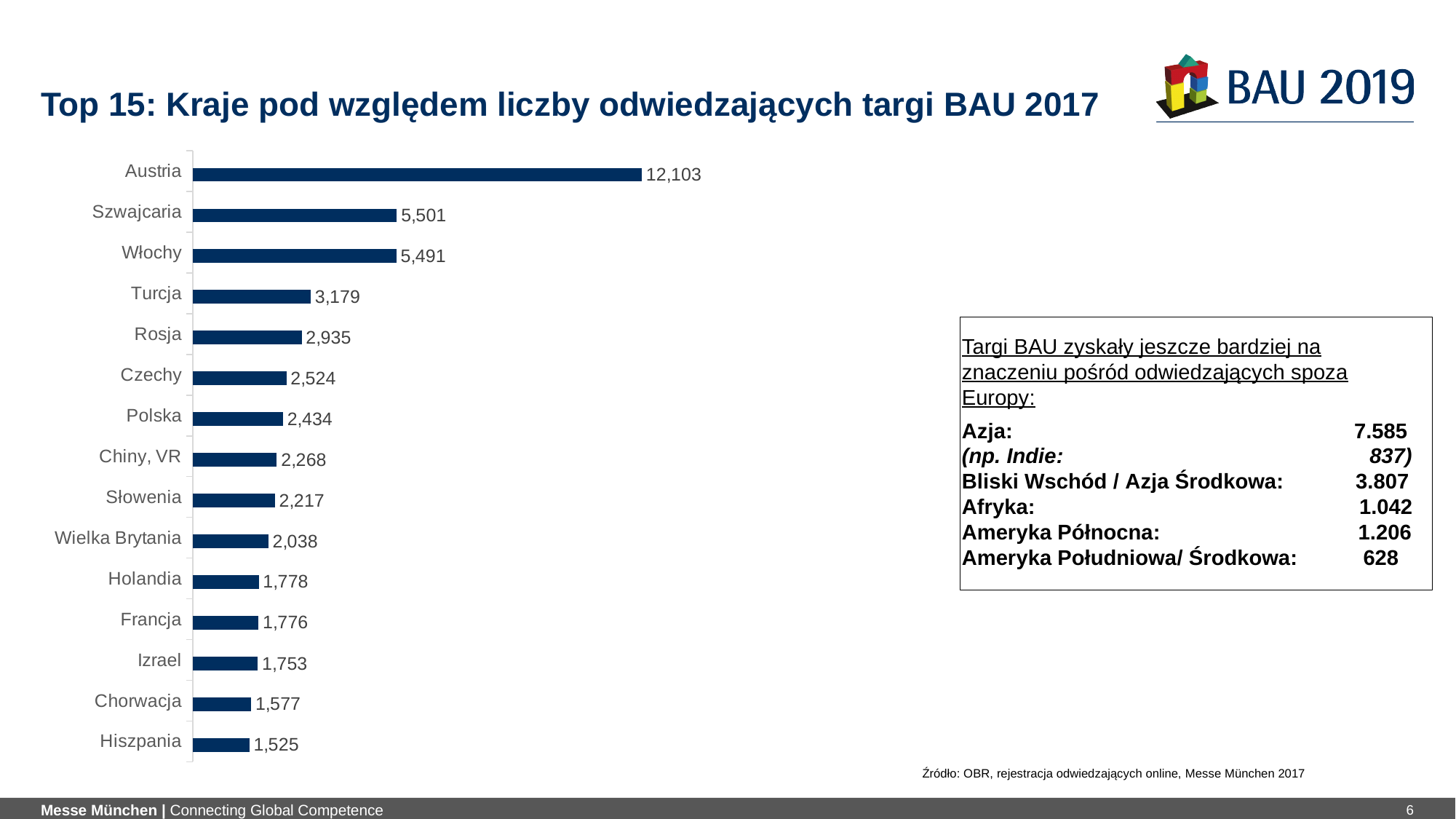
Which country has the lowest number of visitors? Hiszpania What is the difference between the values for Turcja and Rosja? 244 What is the number of visitors from Austria? 12,103 What is the value shown for Polska? 2,434 How many countries are shown in the chart? 15 Which has a larger value, Izrael or Chorwacja? Izrael Which country has the highest number of visitors? Austria Which has a larger value, Czechy or Chiny, VR? Czechy What is the value shown for Wielka Brytania? 2,038 What is the title of the chart? Top 15: Kraje pod względem liczby odwiedzających targi BAU 2017 What type of chart is shown on the slide? Bar chart What is the difference between the values for Austria and Szwajcaria? 6,602